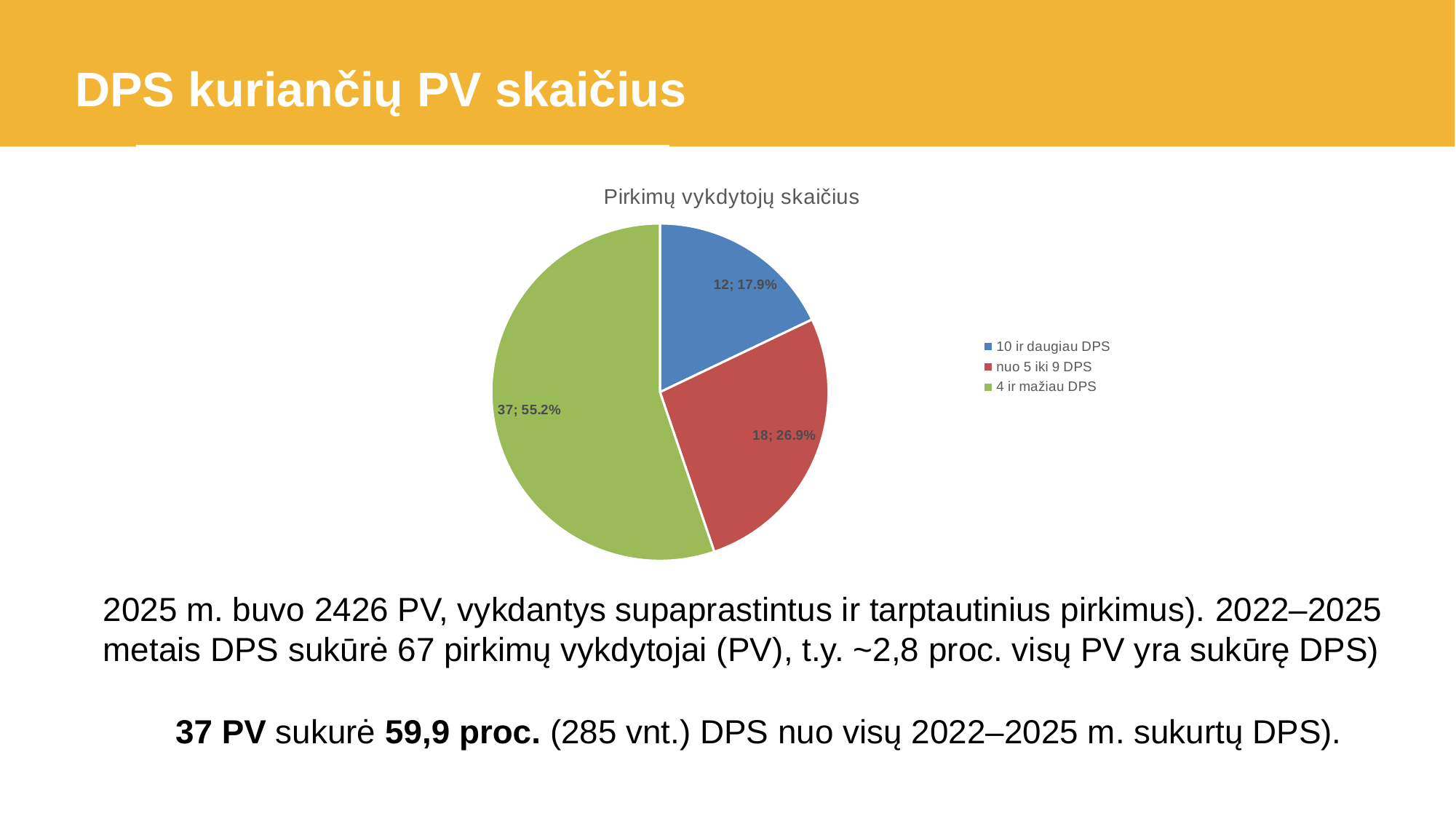
What is the value for '10 ir daugiau DPS'? 12 Which category has the largest slice? 4 ir mažiau DPS What is the title of the chart? Pirkimų vykdytojų skaičius What is the value for 'nuo 5 iki 9 DPS'? 18 Which category has the smallest slice? 10 ir daugiau DPS What share of the pie does '10 ir daugiau DPS' represent? 17.9% What share of the pie does '4 ir mažiau DPS' represent? 55.2% How many entries does the legend list? 3 What is the difference between the values for '4 ir mažiau DPS' and 'nuo 5 iki 9 DPS'? 19 What kind of chart is shown on the slide? pie chart How many slices does the pie chart have? 3 What is the value for '4 ir mažiau DPS'? 37